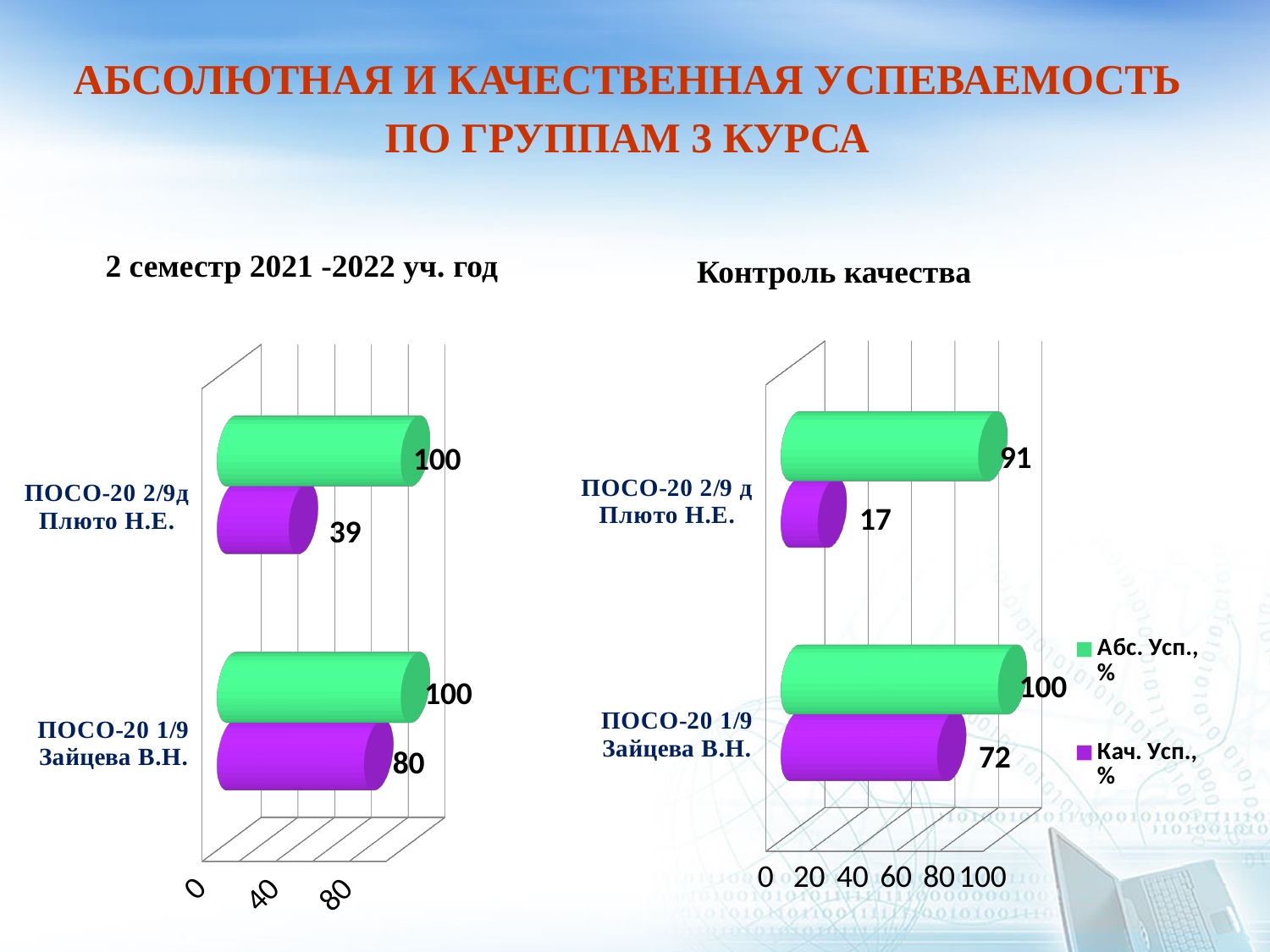
In the chart titled "2 семестр 2021 -2022 уч. год", what is the value of the purple bar for ПОСО-20 1/9 Зайцева В.Н.? 80 In the chart titled "Контроль качества", what is the difference between the green and purple bars for ПОСО-20 1/9 Зайцева В.Н.? 28 What type of chart is the chart titled "2 семестр 2021 -2022 уч. год"? Bar chart How many groups (categories) are shown in the chart titled "Контроль качества"? 2 In the chart titled "2 семестр 2021 -2022 уч. год", is the purple bar for ПОСО-20 2/9д Плюто Н.Е. larger or smaller than the purple bar for ПОСО-20 1/9 Зайцева В.Н.? smaller In the chart titled "2 семестр 2021 -2022 уч. год", what is the value of the purple bar for ПОСО-20 2/9д Плюто Н.Е.? 39 In the chart titled "Контроль качества", what is the value of the purple bar (Кач. Усп., %) for ПОСО-20 2/9 д Плюто Н.Е.? 17 In the chart titled "2 семестр 2021 -2022 уч. год", what is the difference between the purple bars for ПОСО-20 1/9 Зайцева В.Н. and ПОСО-20 2/9д Плюто Н.Е.? 41 How many series does the legend of the chart titled "Контроль качества" list? 2 In the chart titled "Контроль качества", what is the value of the green bar (Абс. Усп., %) for ПОСО-20 2/9 д Плюто Н.Е.? 91 In the chart titled "Контроль качества", which group has the higher green (Абс. Усп., %) value? ПОСО-20 1/9 Зайцева В.Н. In the chart titled "Контроль качества", which group has the lower purple (Кач. Усп., %) value? ПОСО-20 2/9 д Плюто Н.Е.